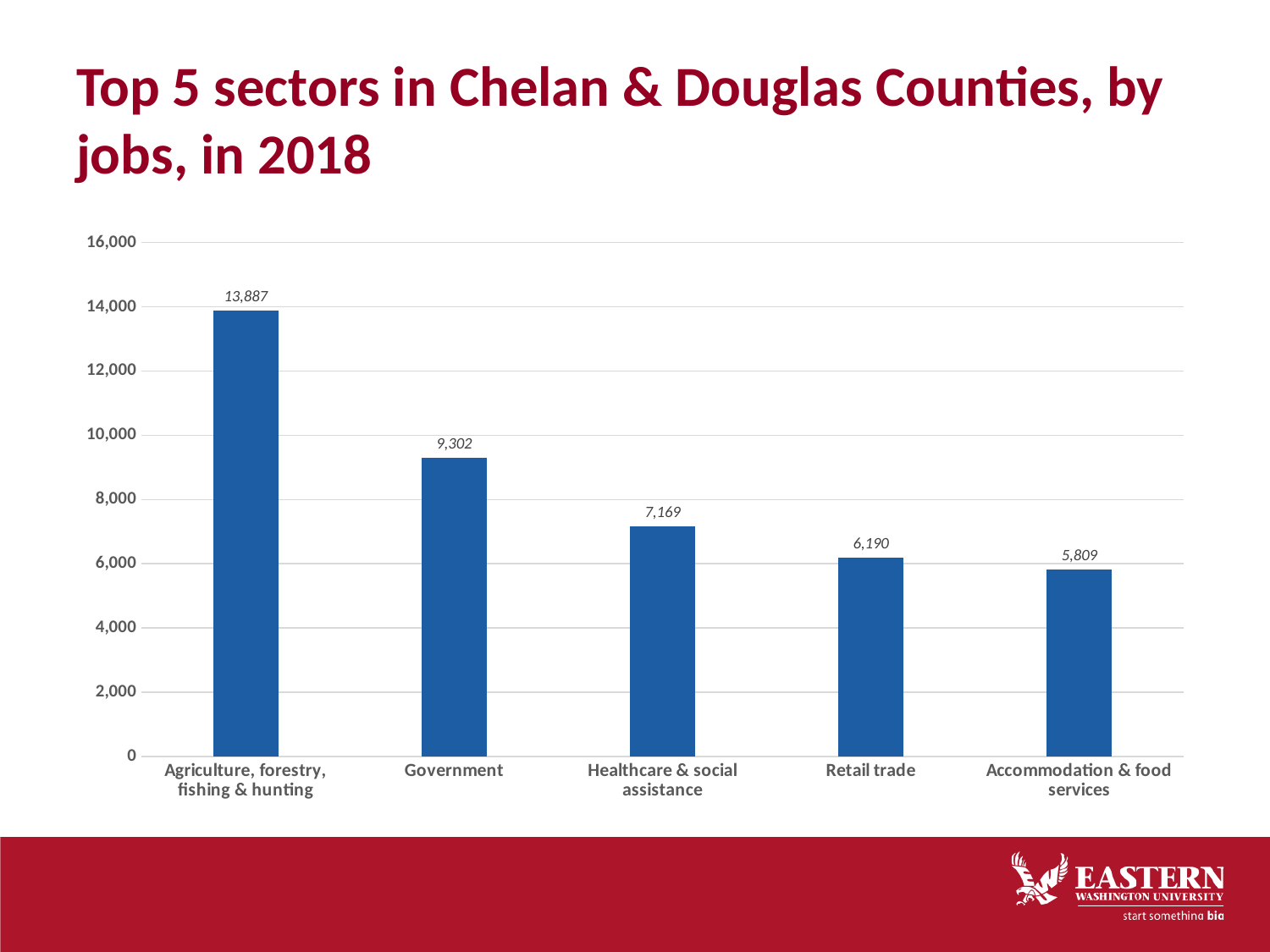
What is the value for Healthcare & social assistance? 7,169 What is the difference in jobs between Retail trade and Accommodation & food services? 381 Which sector has the lowest number of jobs? Accommodation & food services Which sector has the highest number of jobs? Agriculture, forestry, fishing & hunting How many jobs does the Government sector have? 9,302 What is the difference in jobs between Agriculture, forestry, fishing & hunting and Government? 4,585 Is the value for Government greater or less than 10,000? less How many sectors are shown in the chart? 5 What is the value for Accommodation & food services? 5,809 Which has more jobs, Healthcare & social assistance or Retail trade? Healthcare & social assistance What kind of chart is shown on the slide? Bar chart Do the values rise or fall from left to right across the sectors? Fall